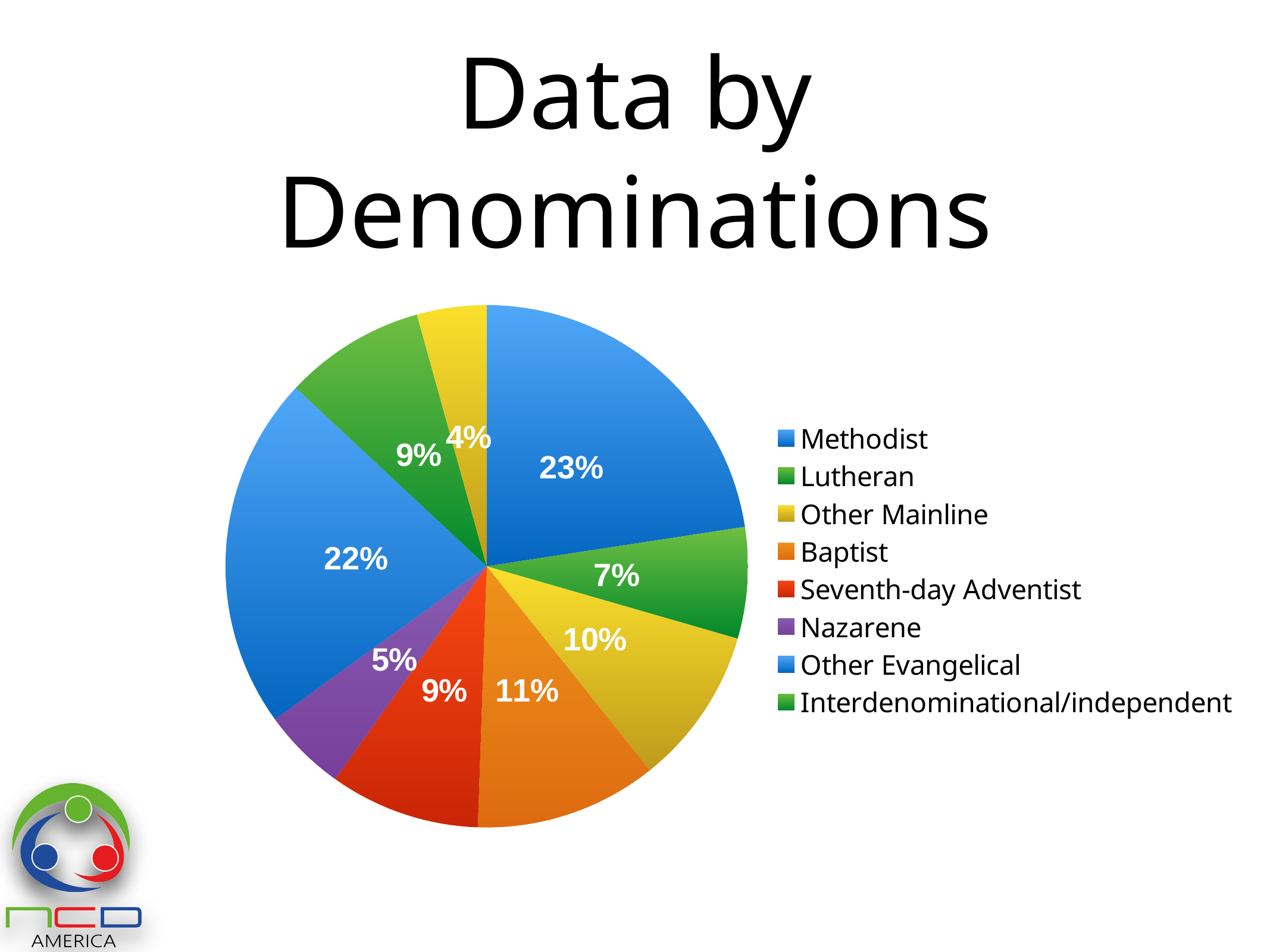
What share of the pie does Other Evangelical have? 22% What percentage is shown for Lutheran? 7% What share of the pie does Methodist have? 23% Which denomination has the largest share of the pie? Methodist Which is larger, the share for Baptist or the share for Other Mainline? Baptist How many entries does the legend list? 8 What is the difference between the Methodist share and the Lutheran share? 16% What percentage is shown for Baptist? 11% What percentage is shown for Seventh-day Adventist? 9% What type of chart is shown on the slide? pie chart What percentage is shown for Nazarene? 5% What is the title of the chart on the slide? Data by Denominations